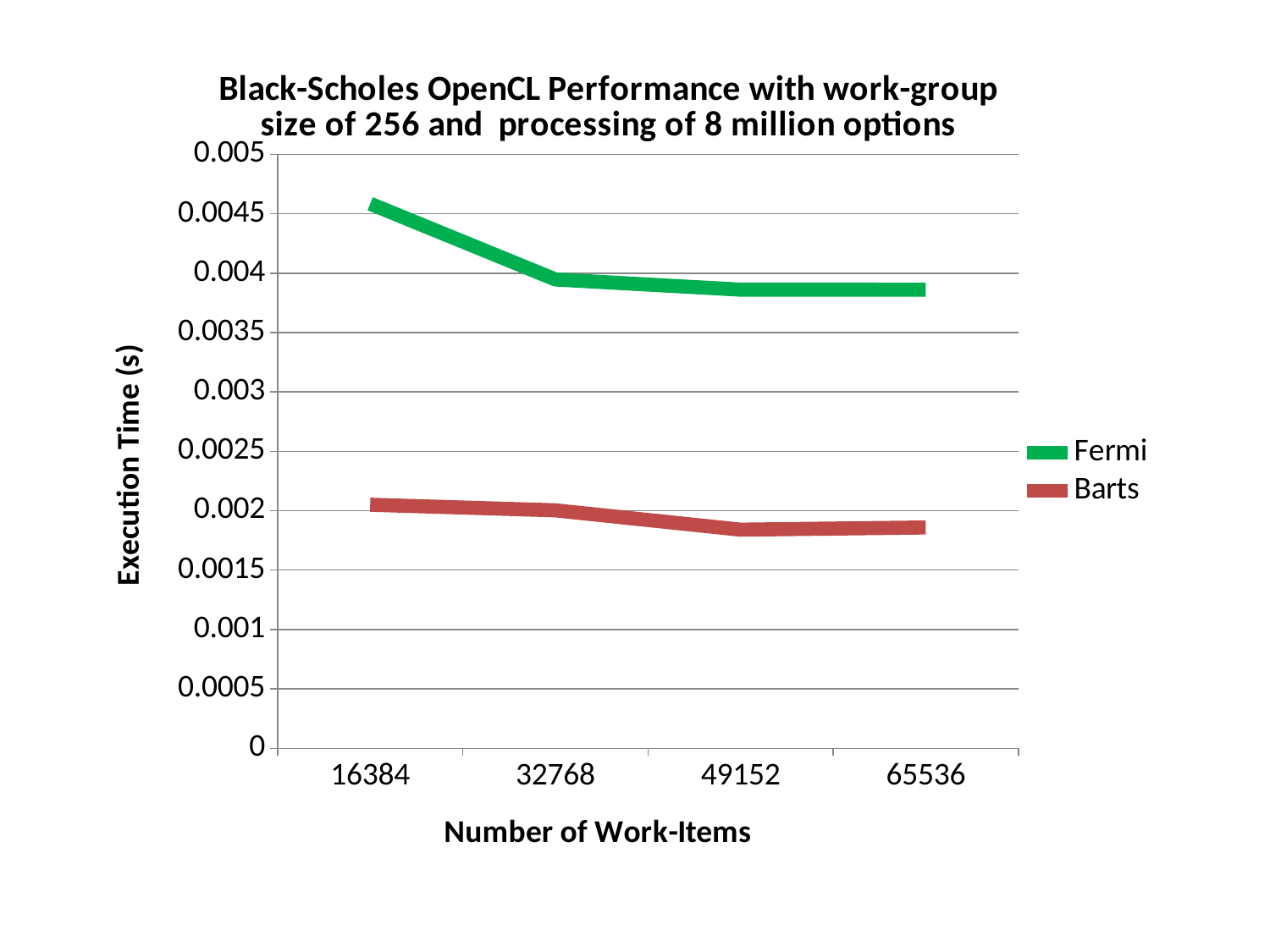
What kind of chart is shown on the slide? line chart Is the Fermi execution time at 16384 work-items greater or less than 0.004? greater Does the Fermi execution time rise or fall as the number of work-items increases from 16384 to 49152? fall What is the label of the y axis? Execution Time (s) How many series does the legend list? 2 How many points along the x axis are plotted for each series? 4 At which number of work-items is the Fermi execution time highest? 16384 Which series has the higher execution time at 32768 work-items, Fermi or Barts? Fermi Is the Barts execution time at 16384 work-items greater or less than 0.0025? less At which number of work-items is the Barts execution time highest? 16384 Is the Barts execution time at 49152 work-items greater or less than 0.002? less